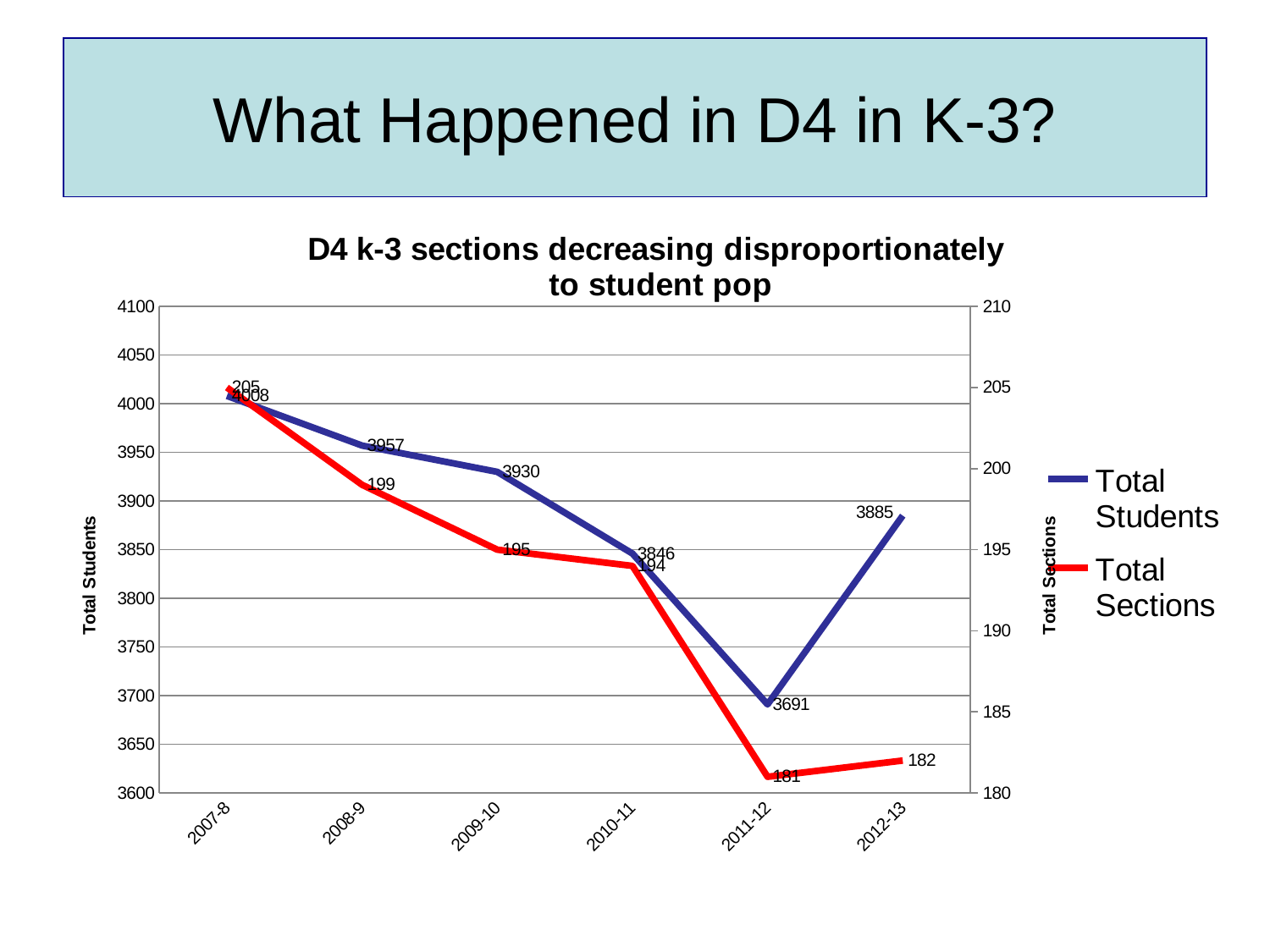
In which school year is Total Sections highest? 2007-8 In which school year is Total Students lowest? 2011-12 What is the title of the chart? D4 k-3 sections decreasing disproportionately to student pop What type of chart is shown on the slide? line chart How many series does the legend list? 2 What is the value of Total Sections for 2008-9? 199 What is the difference in Total Students between 2012-13 and 2011-12? 194 What is the value of Total Sections for 2012-13? 182 What is the value of Total Students for 2011-12? 3691 How many school years are plotted along the x axis? 6 What is the value of Total Students for 2012-13? 3885 Which is larger, Total Sections in 2009-10 or in 2010-11? 2009-10